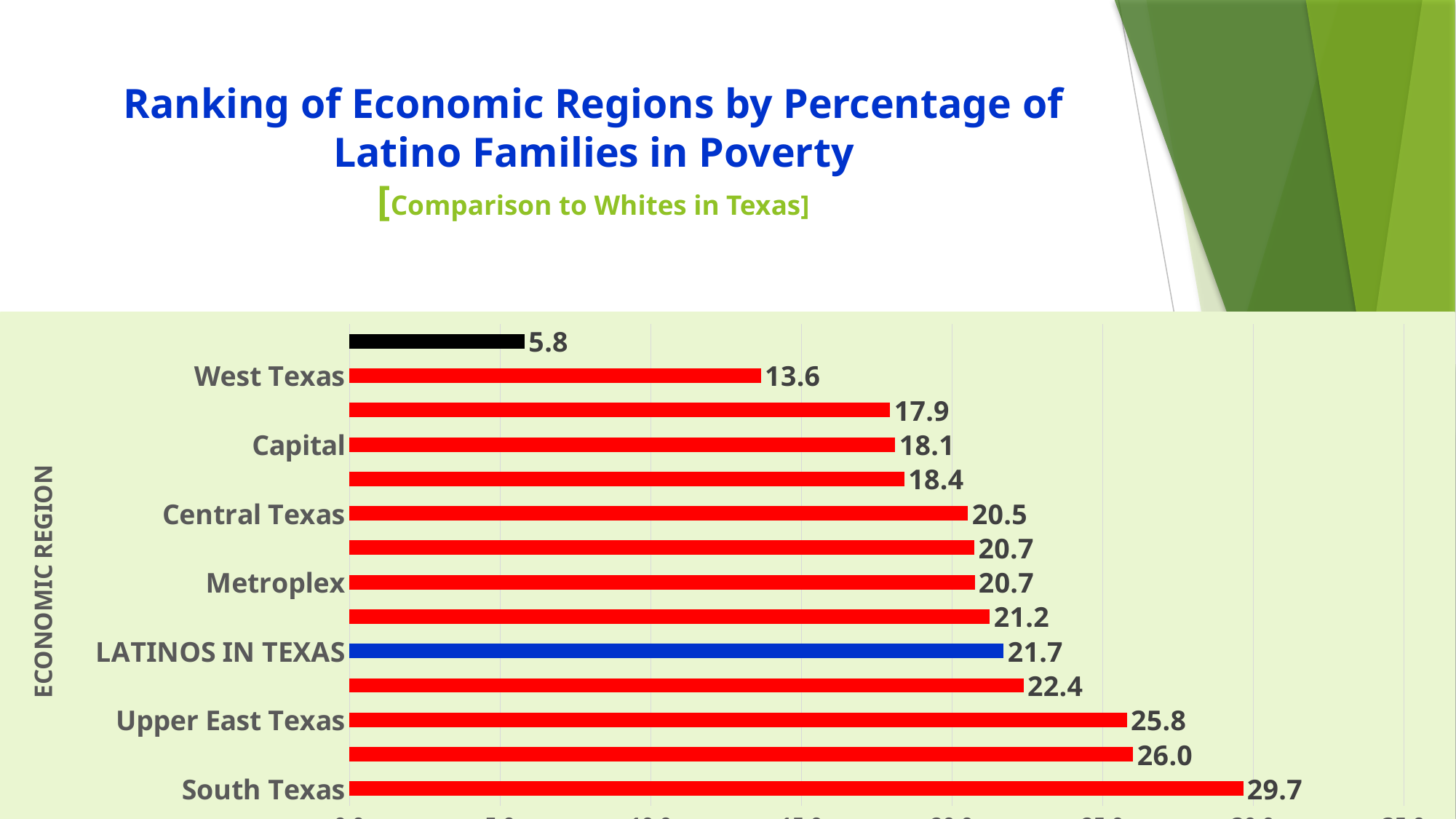
What is the value for Upper East Texas? 25.8 What is the difference between the values for Upper East Texas and Central Texas? 5.3 Which labelled region has the highest value? South Texas What is the difference between the values for South Texas and West Texas? 16.1 What is the value for Capital? 18.1 Which is larger, the value for Metroplex or the value for Capital? Metroplex What is the value of the shortest bar in the chart? 5.8 What kind of chart is shown on the slide? Bar chart What is the value for South Texas? 29.7 What is the value for LATINOS IN TEXAS? 21.7 How many bars are plotted in the chart? 14 What is the value for West Texas? 13.6